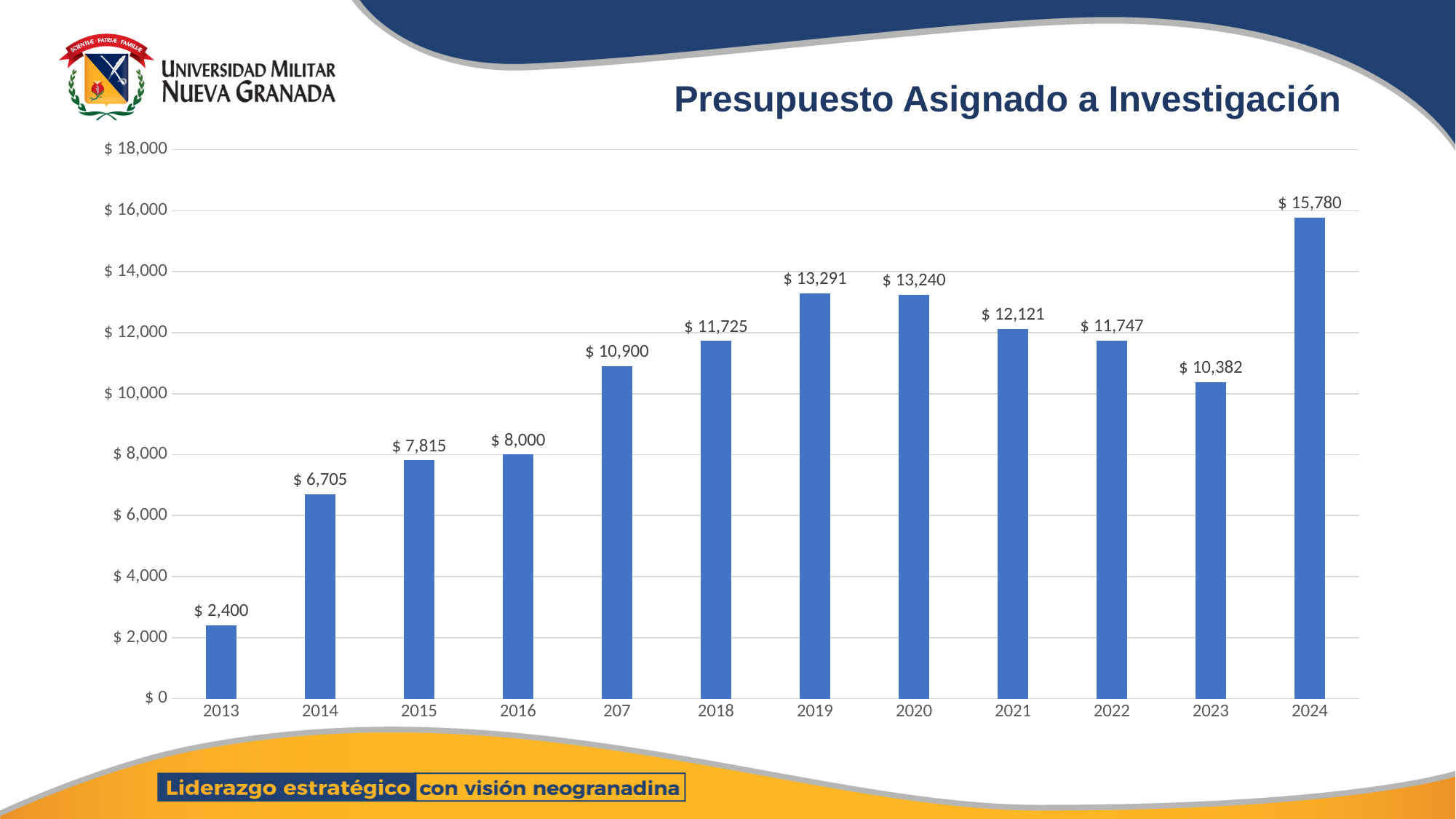
What is the value for 2022? $ 11,747 Which year has the lowest value? 2013 What is the difference between the values for 2019 and 2020? $ 51 Which year has the highest value? 2024 How many bars are shown in the chart? 12 What is the difference between the values for 2024 and 2023? $ 5,398 What kind of chart is shown on the slide? Bar chart What is the value for 2024? $ 15,780 From 2020 to 2023, do the values rise or fall? Fall What is the value for 2019? $ 13,291 What is the value for 2013? $ 2,400 Which is larger, the value for 2021 or the value for 2023? 2021